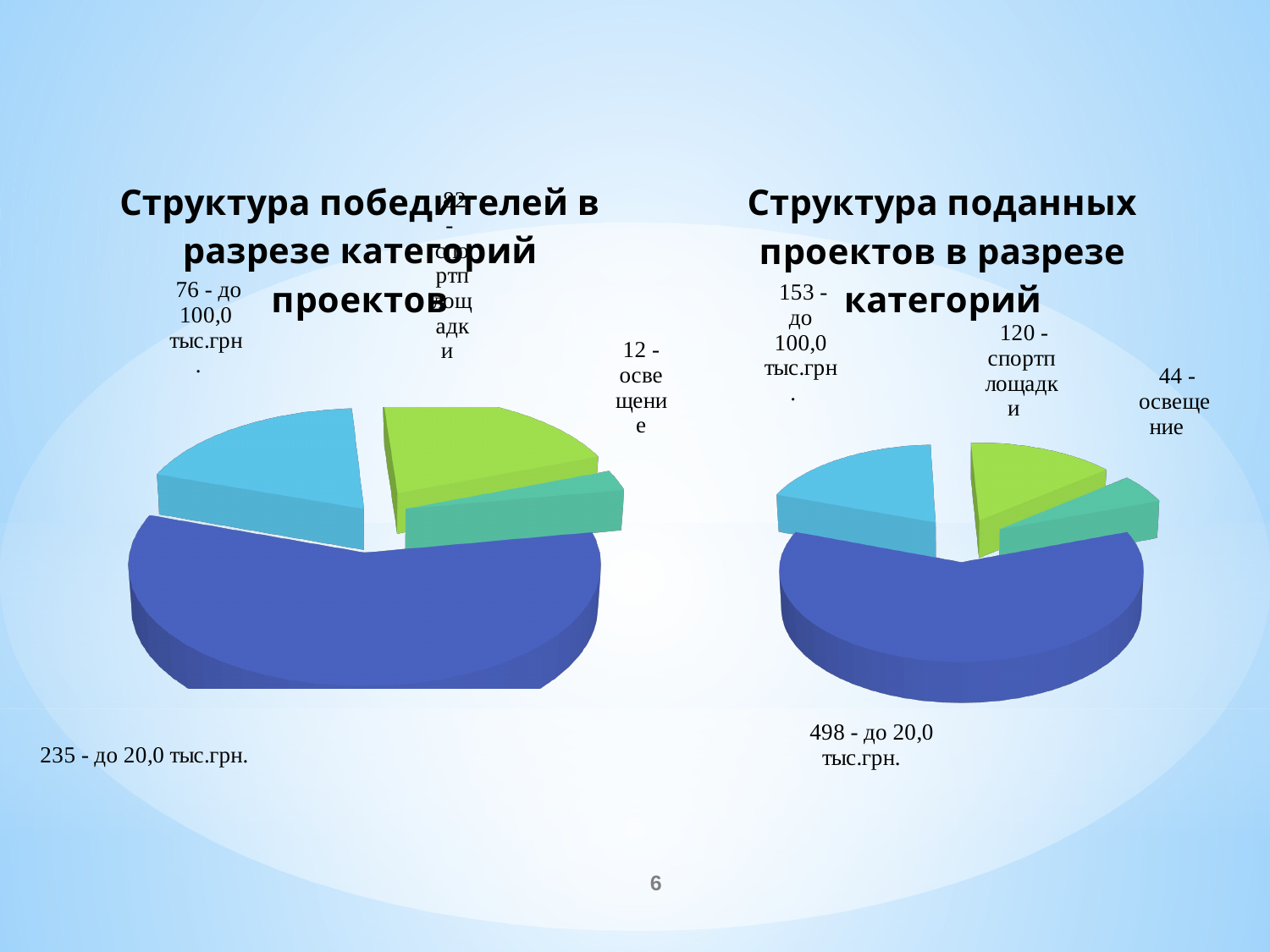
In the left chart ("Структура победителей в разрезе категорий проектов"), what is the value for "освещение"? 12 In the left chart ("Структура победителей в разрезе категорий проектов"), which category has the largest slice? до 20,0 тыс.грн. In the right chart ("Структура поданных проектов в разрезе категорий"), what is the total of all four categories? 815 In the left chart ("Структура победителей в разрезе категорий проектов"), what is the value for "до 20,0 тыс.грн."? 235 In the left chart ("Структура победителей в разрезе категорий проектов"), what is the value for "до 100,0 тыс.грн."? 76 In the left chart ("Структура победителей в разрезе категорий проектов"), which category has the smallest slice? освещение How many categories are shown in the right chart ("Структура поданных проектов в разрезе категорий")? 4 In the right chart ("Структура поданных проектов в разрезе категорий"), what is the value for "до 20,0 тыс.грн."? 498 In the right chart ("Структура поданных проектов в разрезе категорий"), which is larger: "до 100,0 тыс.грн." or "спортплощадки"? до 100,0 тыс.грн. What kind of chart is used on the left side of the slide, titled "Структура победителей в разрезе категорий проектов"? Pie chart In the right chart ("Структура поданных проектов в разрезе категорий"), what is the value for "спортплощадки"? 120 In the right chart ("Структура поданных проектов в разрезе категорий"), what is the difference between the values for "до 100,0 тыс.грн." and "освещение"? 109